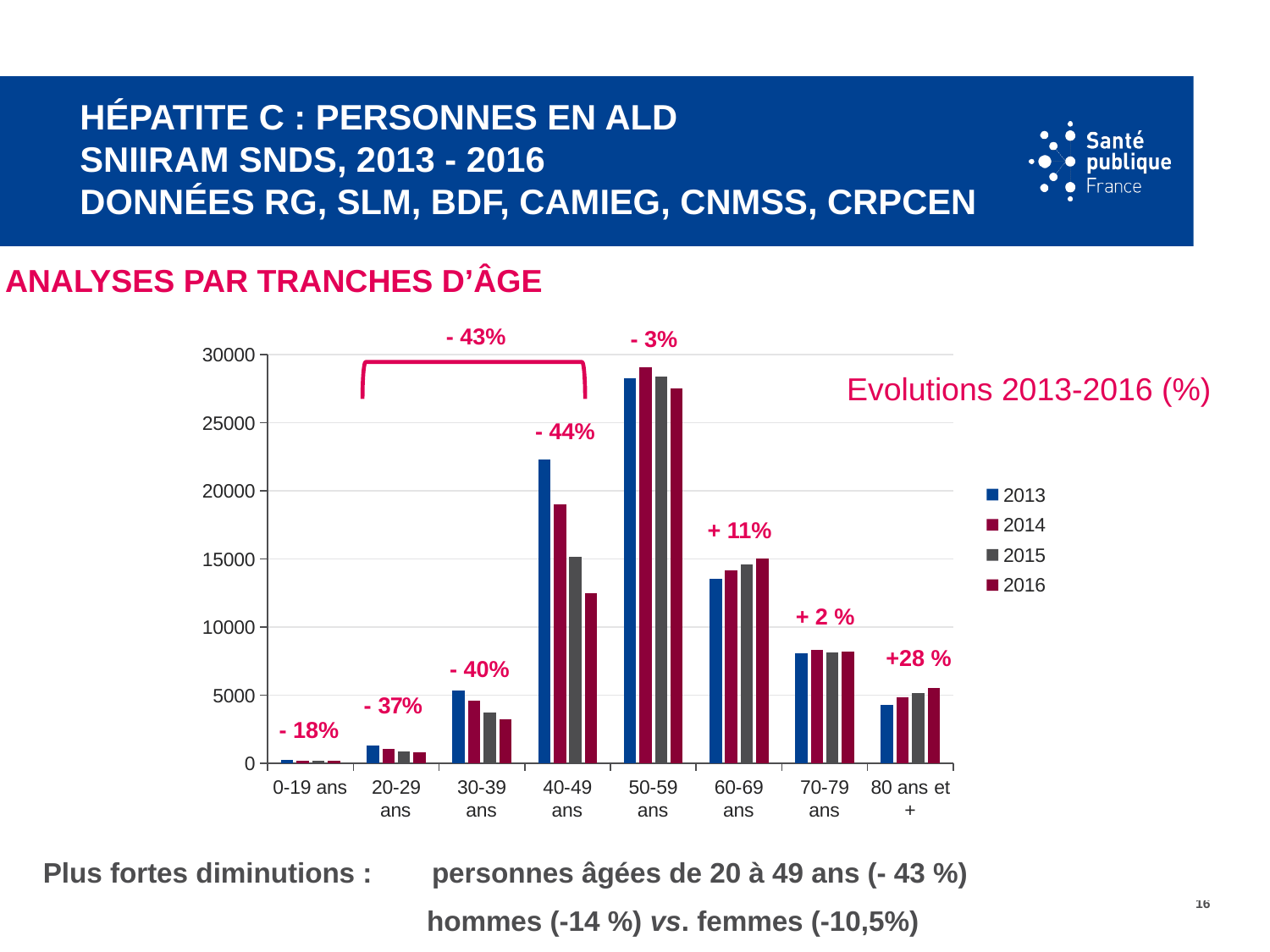
What kind of chart is shown on the slide? bar chart For 40-49 ans, which is larger: the 2013 value or the 2016 value? 2013 Which age group has the lowest number of people in ALD? 0-19 ans For 60-69 ans, which is larger: the 2013 value or the 2016 value? 2016 How many age groups are shown on the x axis of the chart? 8 What is the 2013-2016 evolution shown above the 40-49 ans group? - 44% How many series does the chart legend list? 4 Is the 2013 value for 40-49 ans greater or less than 20000? greater Which age group has the highest number of people in ALD? 50-59 ans Is the 2014 value for 50-59 ans greater or less than 25000? greater Is the 2016 value for 40-49 ans greater or less than 15000? less Do the values for 40-49 ans rise or fall from 2013 to 2016? fall